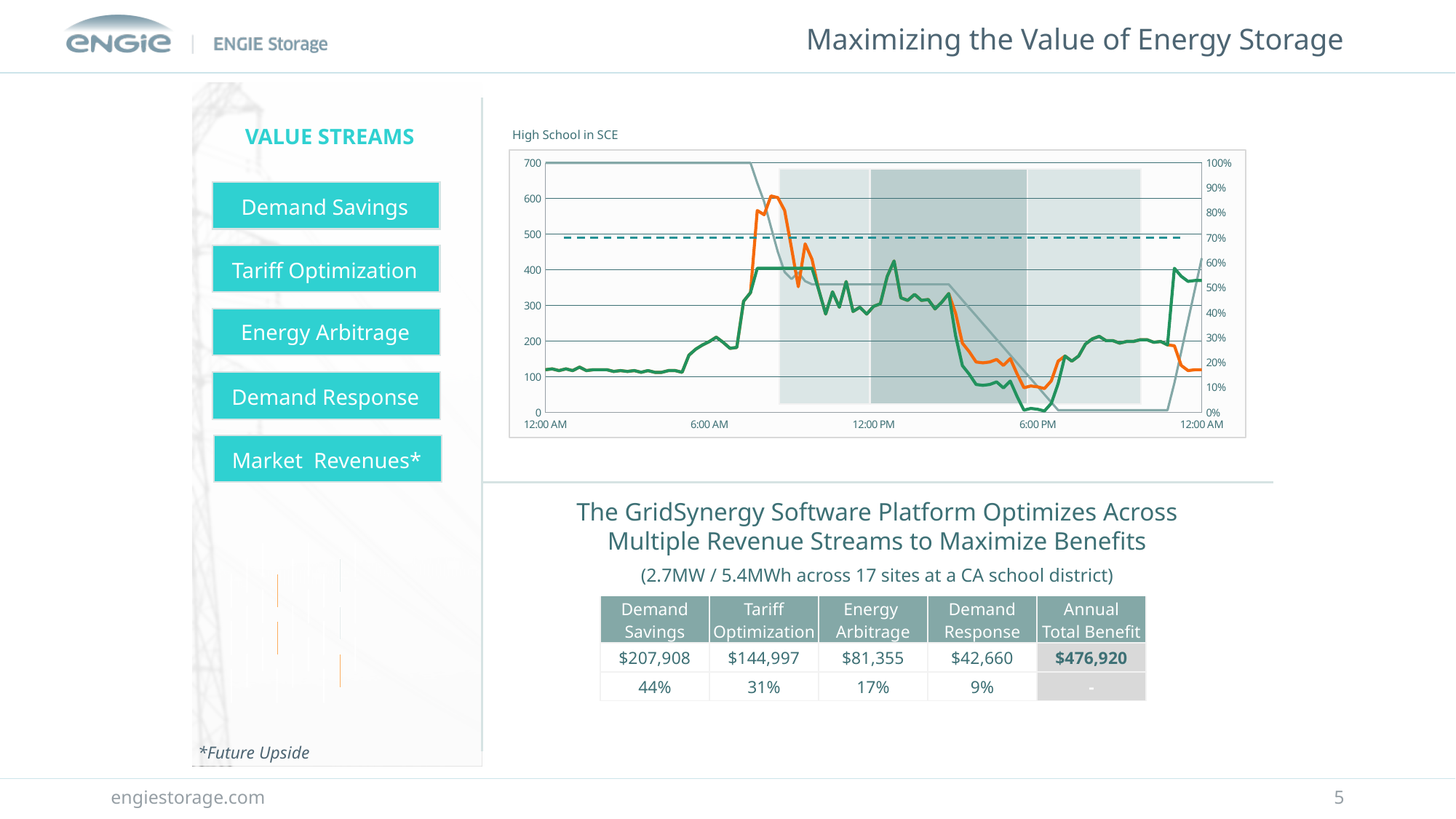
What is the title of the chart on the slide? High School in SCE Is the horizontal dashed line on the chart above or below 400 on the left axis? above Is the peak value of the orange line greater or less than 500? greater Is the value of the green line at 12:00 AM (start of the chart) greater or less than 200? less What is the highest value shown on the right vertical axis of the chart? 100% What is the highest value shown on the left vertical axis of the chart? 700 Does the grey line rise or fall between 6:00 AM and 6:00 PM? fall What colours are the three lines plotted on the chart? orange, green and grey How many time labels are shown along the x axis of the chart? 5 What kind of chart is the "High School in SCE" chart? line chart